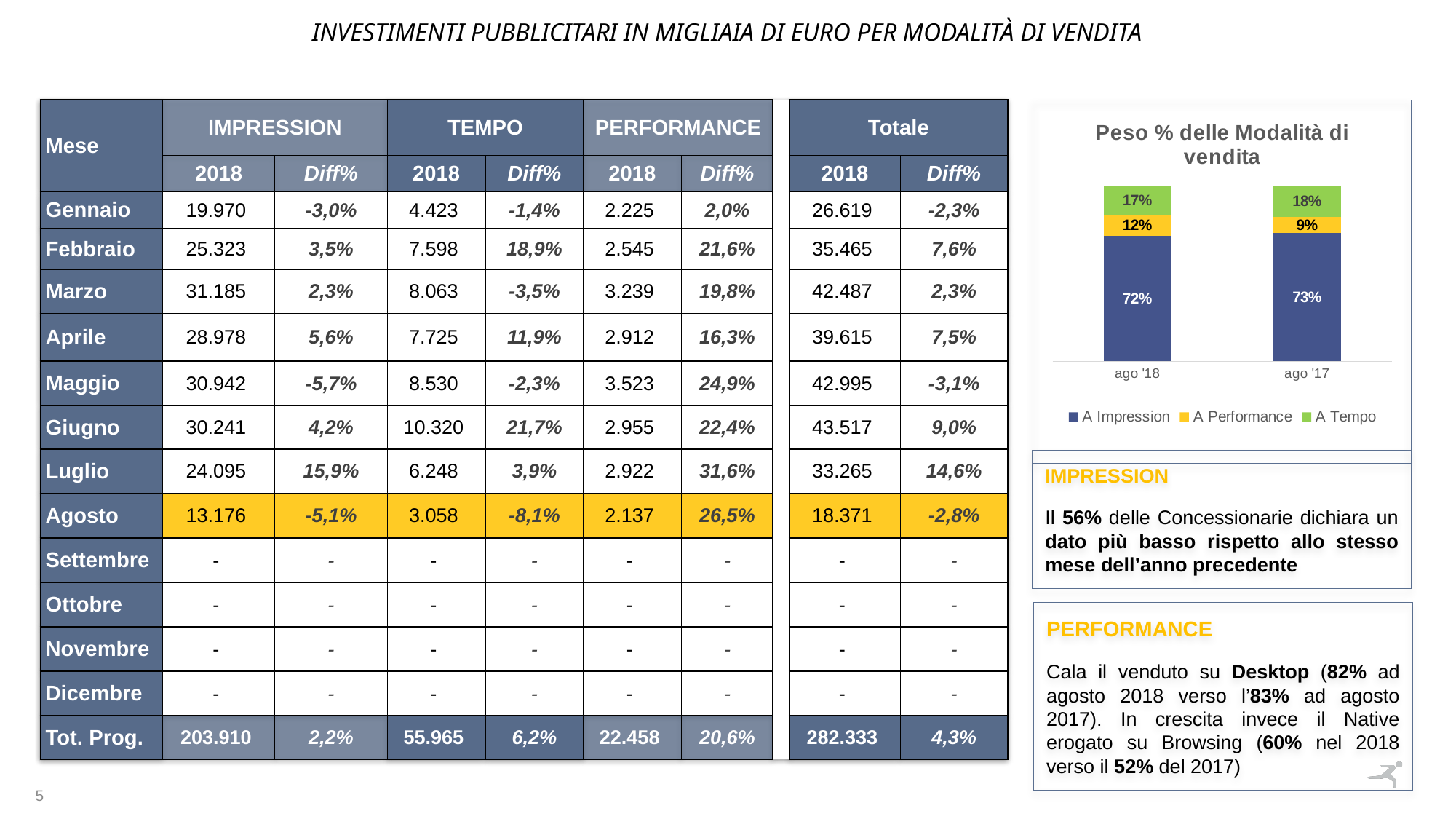
In the chart "Peso % delle Modalità di vendita", what is the value of A Impression for ago '17? 73% In the chart "Peso % delle Modalità di vendita", is the A Tempo share larger for ago '18 or ago '17? ago '17 In the chart "Peso % delle Modalità di vendita", what is the value of A Performance for ago '17? 9% How many series does the legend of the chart "Peso % delle Modalità di vendita" list? 3 In the chart "Peso % delle Modalità di vendita", which series has the largest share in the ago '18 bar? A Impression In the chart "Peso % delle Modalità di vendita", which colour represents A Tempo? Green In the chart "Peso % delle Modalità di vendita", which series has the smallest share in the ago '17 bar? A Performance In the chart "Peso % delle Modalità di vendita", what is the value of A Tempo for ago '18? 17% How many bars are shown in the chart "Peso % delle Modalità di vendita"? 2 In the chart "Peso % delle Modalità di vendita", what is the value of A Impression for ago '18? 72% In the chart "Peso % delle Modalità di vendita", what is the difference between the A Performance values for ago '18 and ago '17? 3% What kind of chart is "Peso % delle Modalità di vendita"? Stacked bar chart